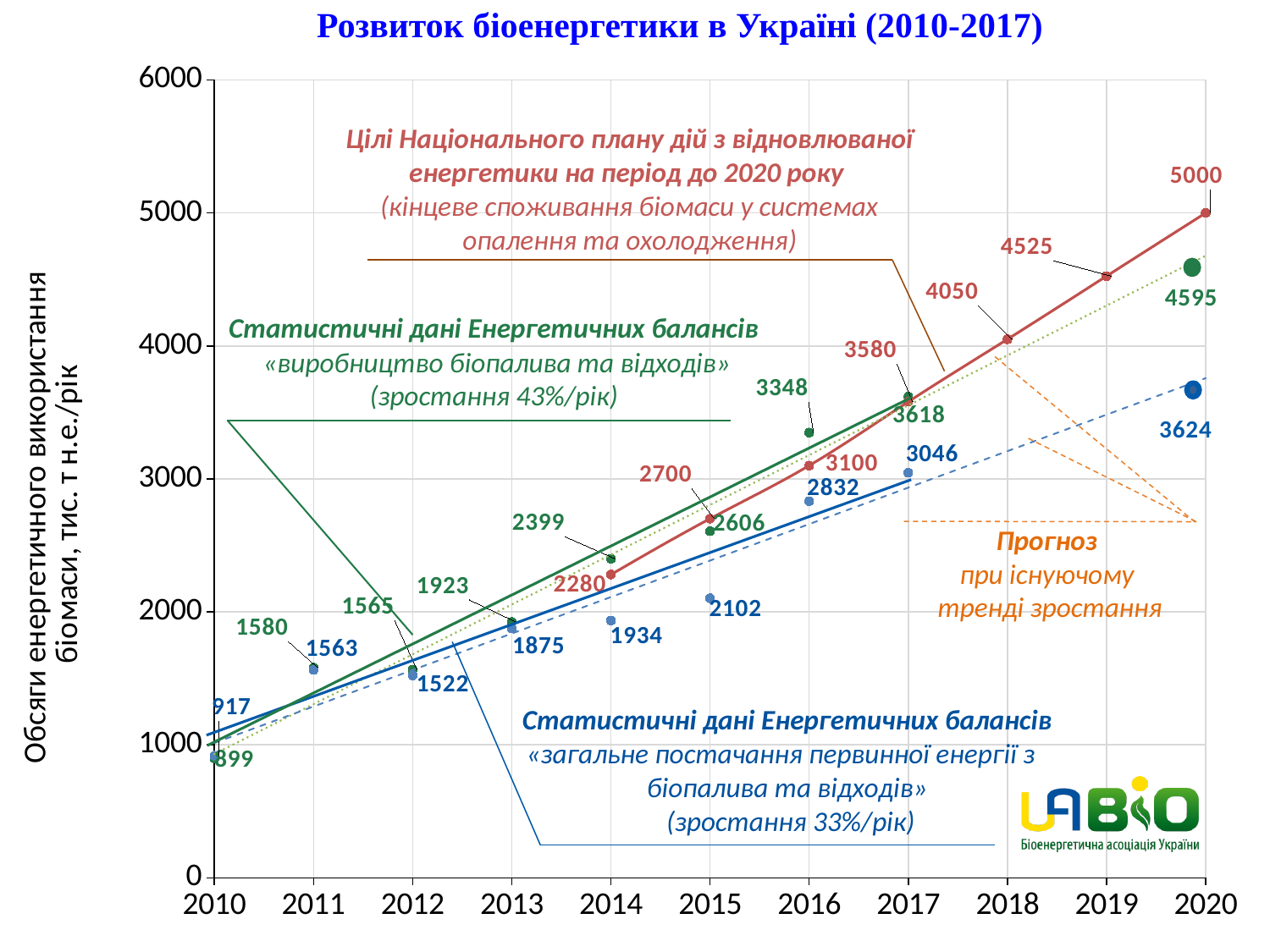
What is the difference between the red target and the green series value in 2017? 38 What is the forecast value for the green series in 2020? 4595 In which year does the red target series reach its highest value? 2020 What annual growth rate is stated for the green series (виробництво біопалива та відходів)? 43%/рік What is the title of the chart? Розвиток біоенергетики в Україні (2010-2017) What is the value of the blue series in 2010? 917 What is the National Action Plan target (red series) for 2020? 5000 What is the value of the blue series (загальне постачання первинної енергії) in 2017? 3046 Which is larger in 2014: the green series value or the red target value? green series (2399) Does the blue series generally rise or fall from 2010 to 2017? rise What is the value of the green series (виробництво біопалива та відходів) in 2016? 3348 What type of chart is shown on the slide? line chart